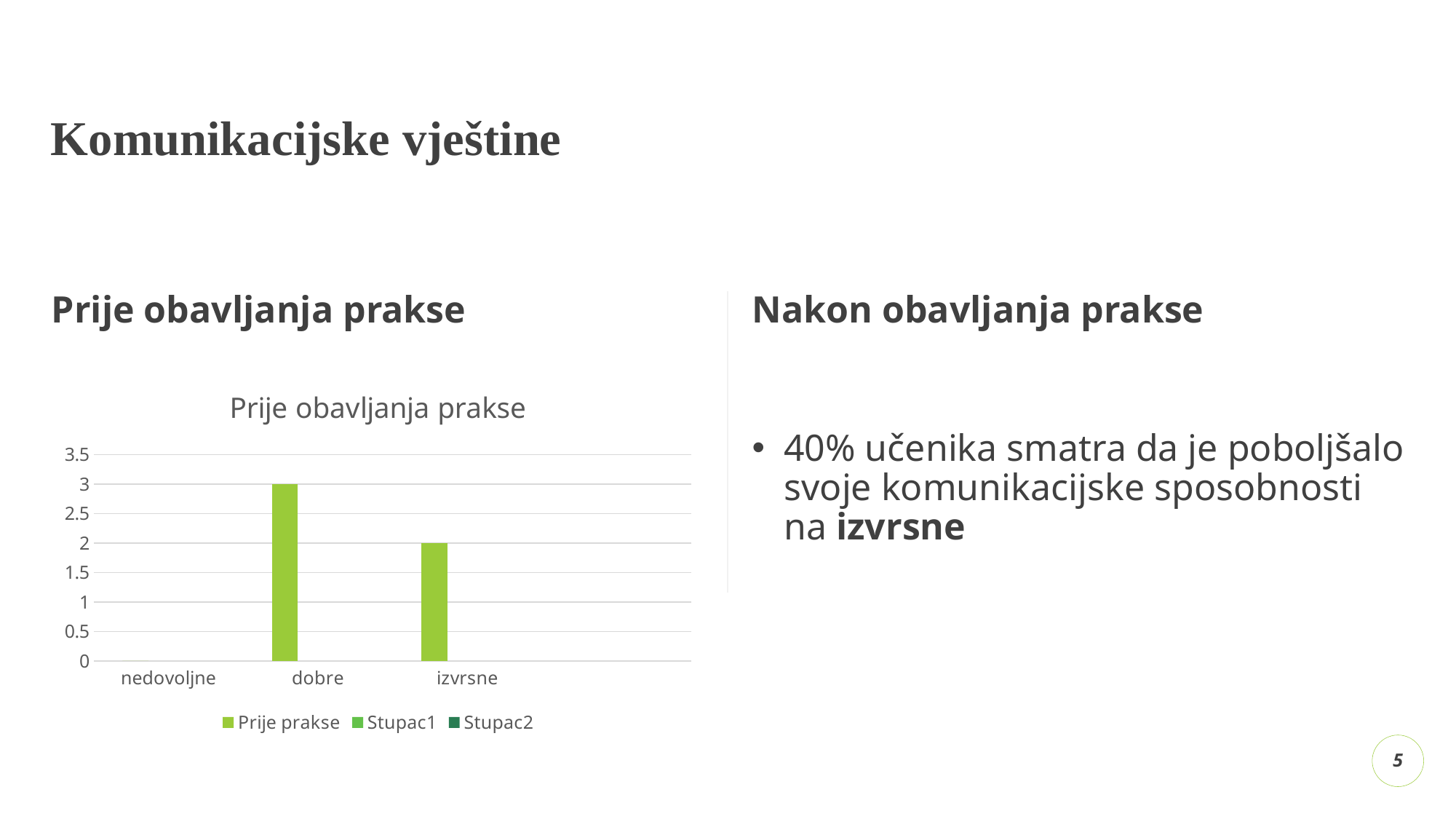
What is the title of the chart? Prije obavljanja prakse Which is larger, the value for dobre or the value for izvrsne? dobre What is the highest value shown on the vertical axis? 3.5 What is the value for dobre? 3 What is the value for izvrsne? 2 What kind of chart is shown on the slide? bar chart Is the value for dobre greater or less than 2.5? greater Which category has the lowest value? nedovoljne How many series does the legend list? 3 Which category has the highest value? dobre How many categories are shown on the x axis? 3 What is the difference between the values for dobre and izvrsne? 1